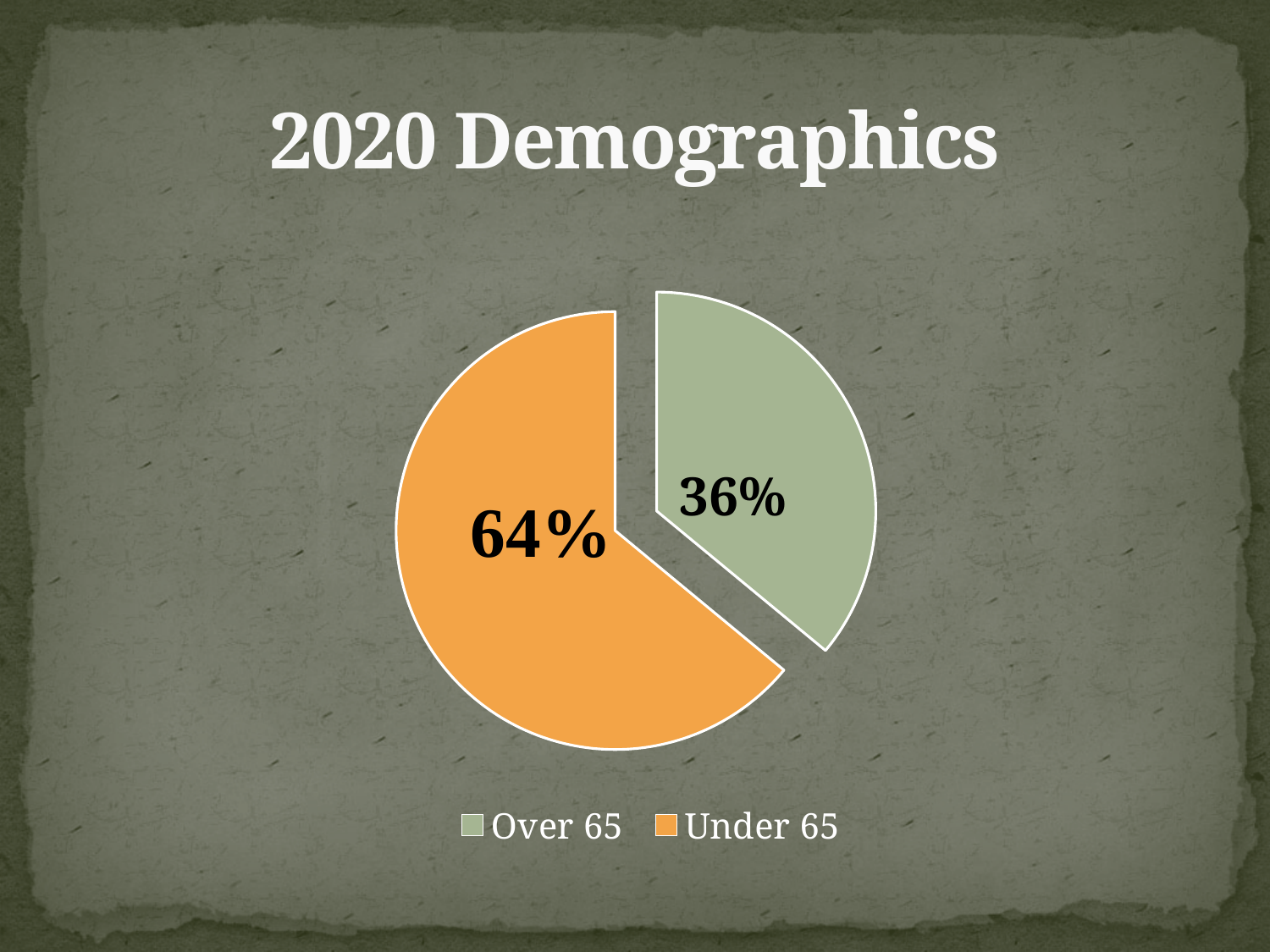
Which slice is the smallest? Over 65 What share of the pie does the Over 65 slice represent? 36% What kind of chart is shown on the slide? pie chart What is the difference in percentage points between the Under 65 and Over 65 slices? 28 What is the title of the slide containing the chart? 2020 Demographics What percentage of the pie is labelled for Over 65? 36% How many slices does the pie chart have? 2 Which is larger, the Over 65 slice or the Under 65 slice? Under 65 What percentage of the pie is labelled for Under 65? 64% What colour is the Under 65 slice? orange How many entries does the legend list? 2 Which slice is the largest? Under 65